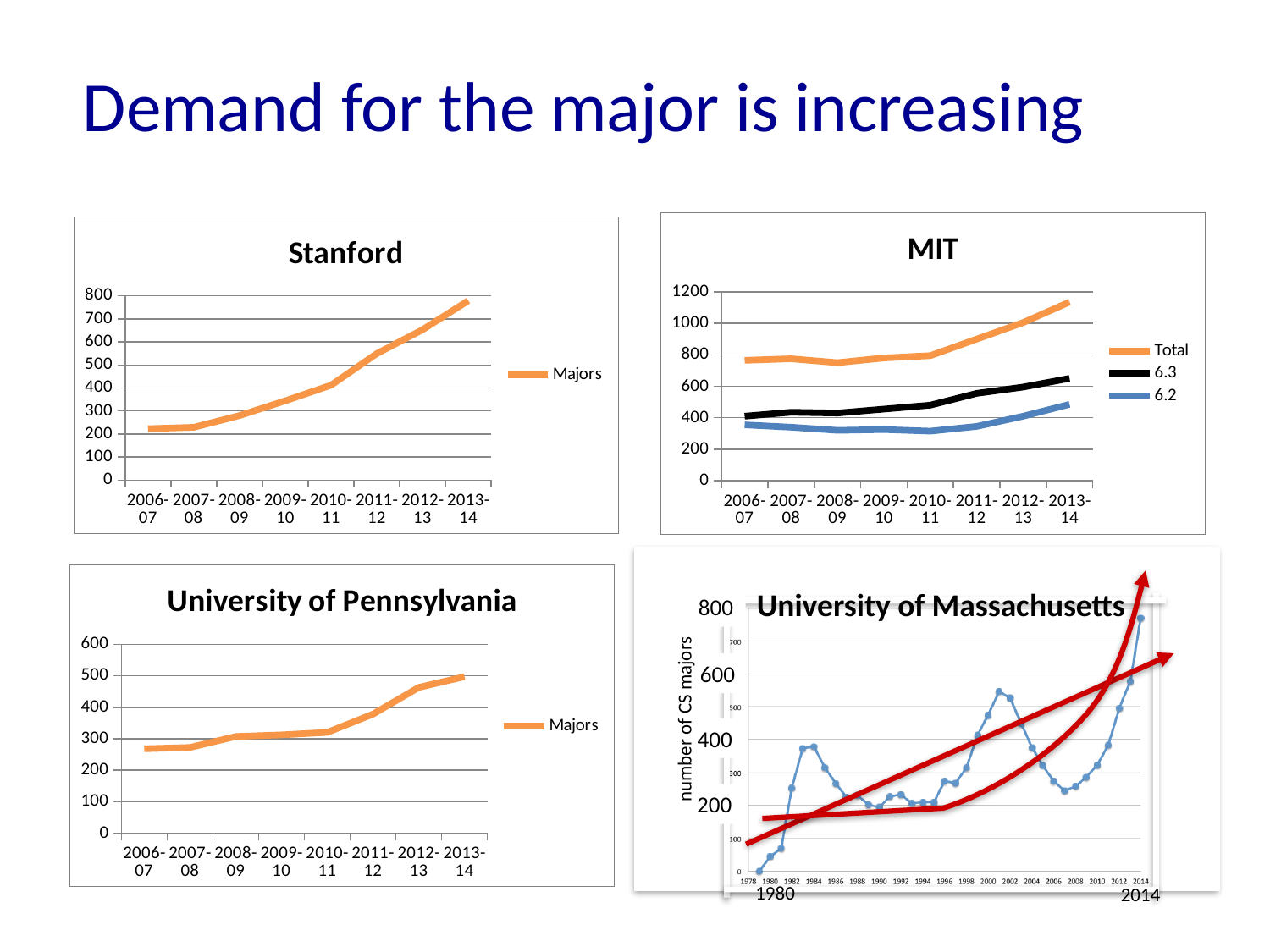
In the Stanford chart, do the values rise or fall from 2006-07 to 2013-14? rise In the Stanford chart, which academic year has the highest number of majors? 2013-14 In the MIT chart, is the 6.2 value for 2006-07 greater or less than 400? less What type of chart is the Stanford chart? line chart What is the y-axis label of the University of Massachusetts chart? number of CS majors How many series does the legend of the MIT chart list? 3 In the University of Pennsylvania chart, which is larger, the value for 2013-14 or the value for 2010-11? 2013-14 In the University of Pennsylvania chart, is the value for 2006-07 greater or less than 300? less In the Stanford chart, how many academic years are shown on the x axis? 8 In the Stanford chart, is the value for 2013-14 greater or less than 700? greater In the MIT chart, which series has the lowest values across all years? 6.2